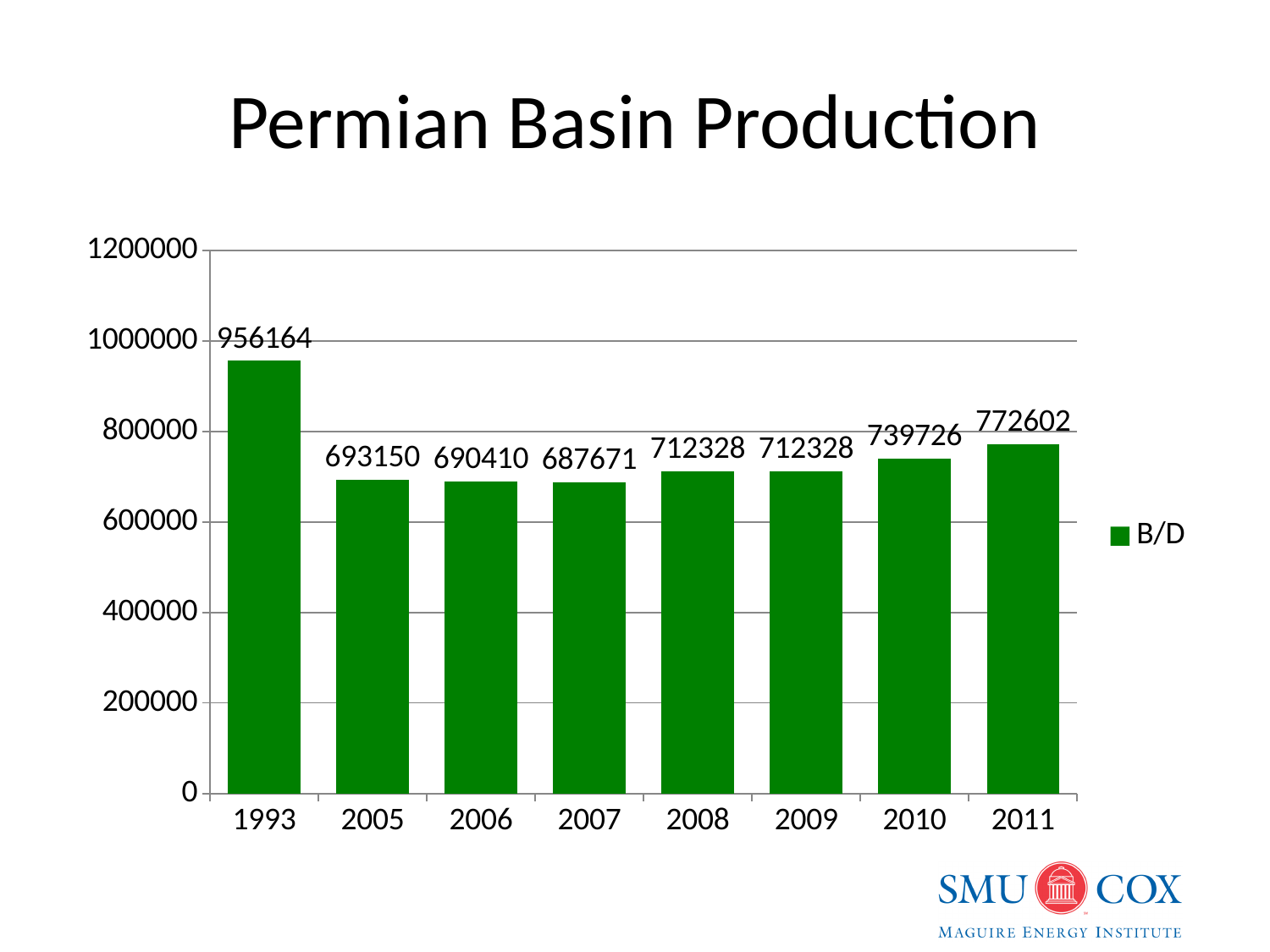
What is the B/D value for 2011? 772602 What kind of chart is shown on the slide? bar chart Which is larger, the B/D value for 2005 or for 2010? 2010 How many years are shown on the x axis? 8 What is the B/D value for 2007? 687671 Which year has the highest B/D value? 1993 What is the B/D value for 1993? 956164 Which year has the lowest B/D value? 2007 Is the B/D value for 2008 greater or less than 800000? less What is the difference between the B/D values for 2011 and 2010? 32876 What is the difference between the B/D values for 1993 and 2011? 183562 What is the title of the chart? Permian Basin Production